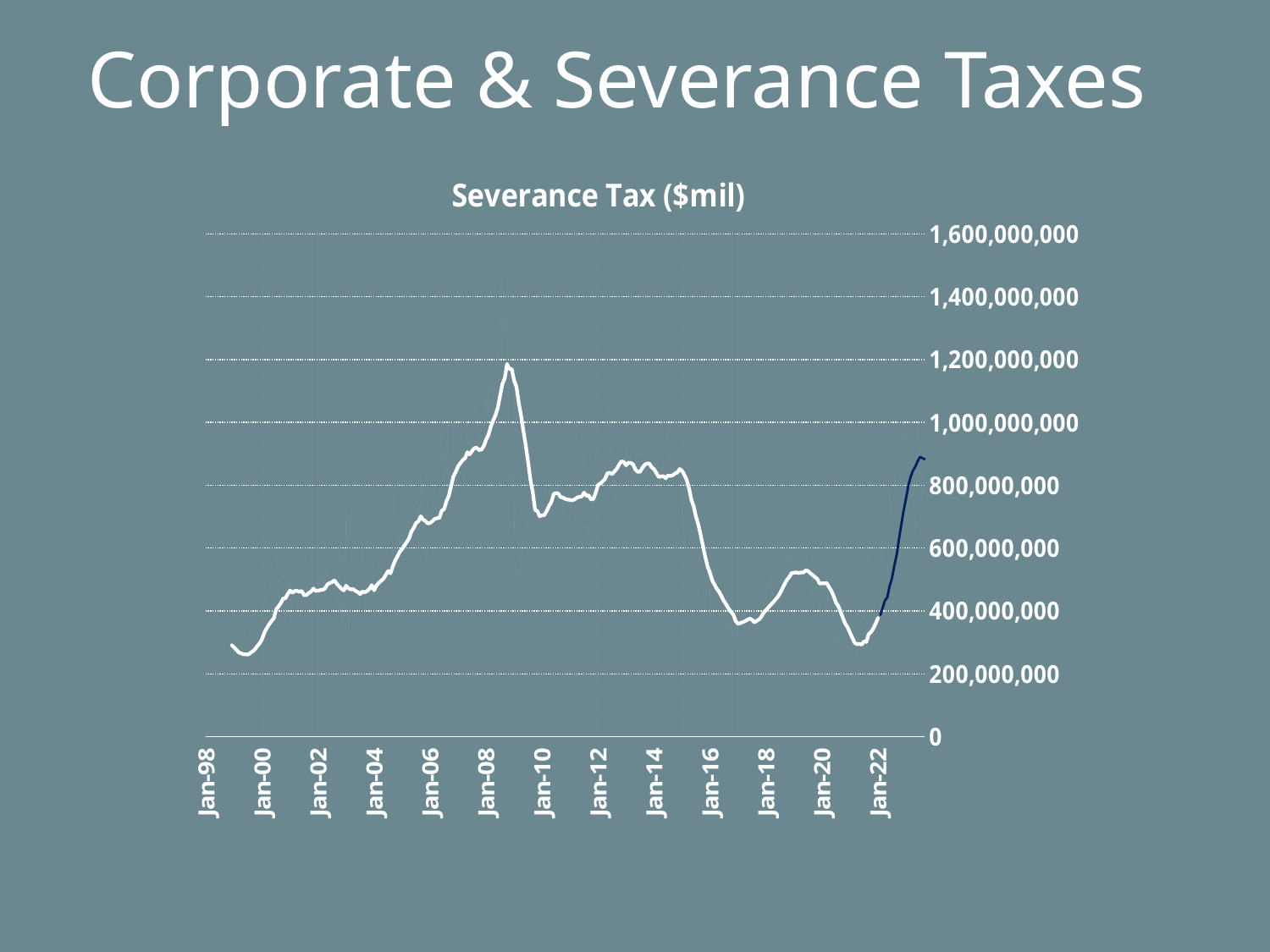
Is the value at Jan-14 larger or smaller than the value at Jan-18? larger Does the line rise or fall between Jan-14 and Jan-16? fall What kind of chart is shown on the slide? line chart Does the line generally rise or fall between Jan-98 and Jan-08? rise Is the value at Jan-98 greater or less than 400,000,000? less Is the value at Jan-20 greater or less than 600,000,000? less Is the value at Jan-04 greater or less than 200,000,000? greater How many year labels are shown along the horizontal axis? 13 What is the title of the chart? Severance Tax ($mil) What is the highest value labelled on the vertical axis? 1,600,000,000